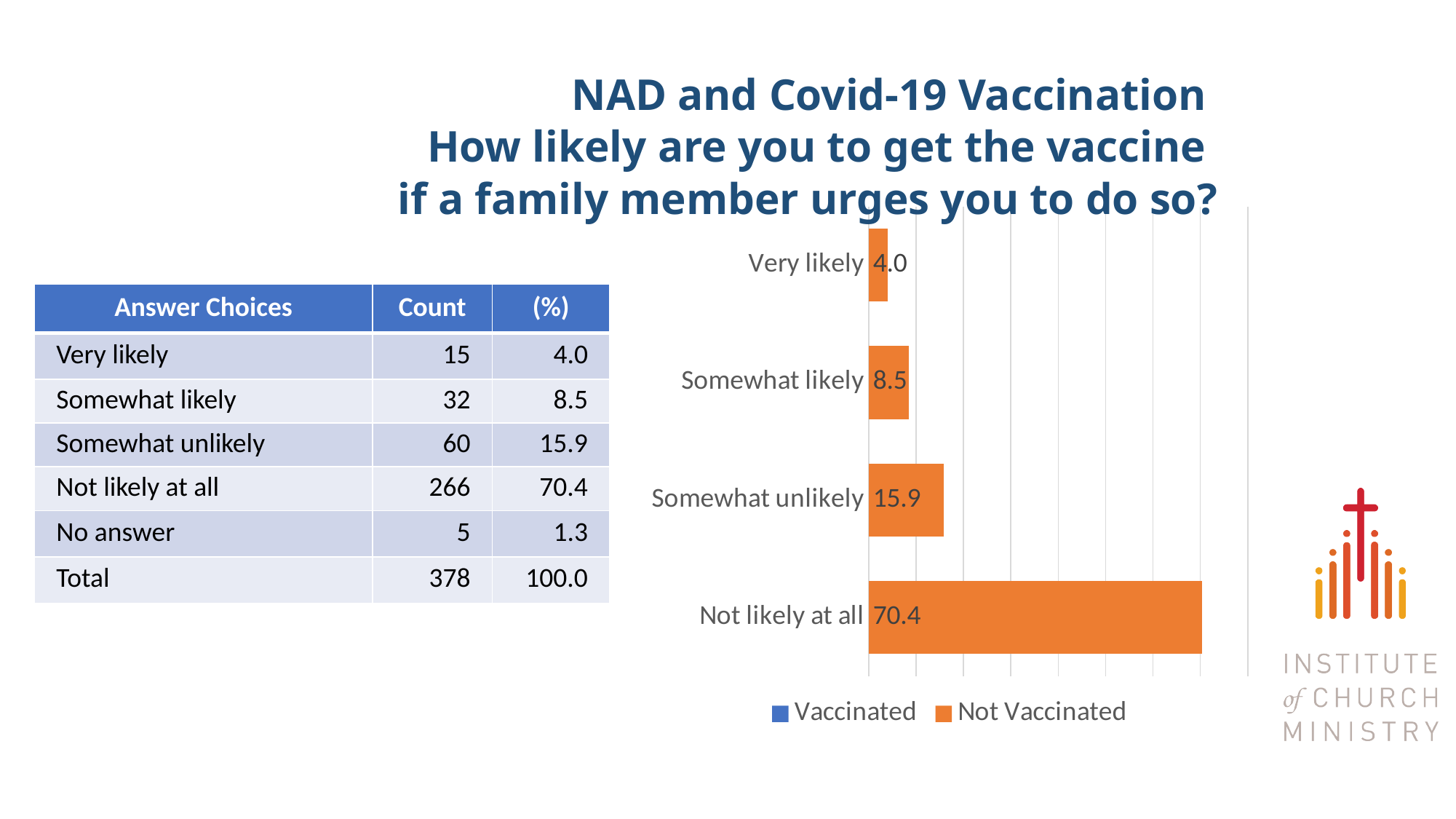
What is the difference between the values for Somewhat likely and Very likely? 4.5 Which is larger, the value for Somewhat likely or the value for Somewhat unlikely? Somewhat unlikely What is the value for Not likely at all in the chart? 70.4 How many categories are plotted in the chart? 4 How many series does the chart legend list? 2 What is the difference between the values for Not likely at all and Somewhat unlikely? 54.5 Which category has the highest value in the chart? Not likely at all What is the value for Very likely in the chart? 4.0 What kind of chart is shown on the slide? Bar chart What is the value for Somewhat unlikely in the chart? 15.9 What is the value for Somewhat likely in the chart? 8.5 Which category has the lowest value in the chart? Very likely